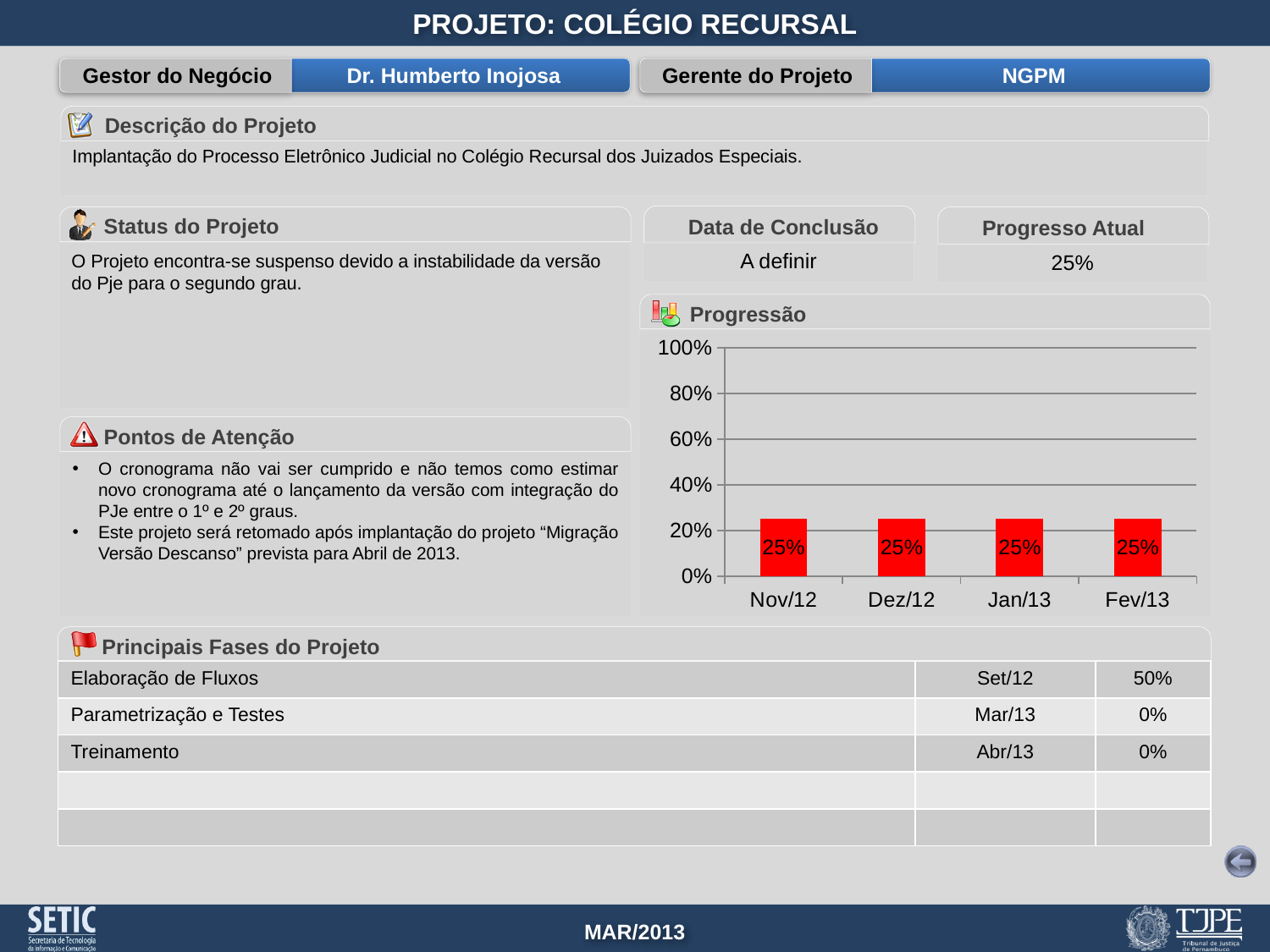
What colour are the bars in the Progressão chart? red Is the value for Dez/12 in the Progressão chart greater or less than 60%? less What is the value for Fev/13 in the Progressão chart? 25% What is the value for Dez/12 in the Progressão chart? 25% Do the values in the Progressão chart rise, fall or stay flat from Nov/12 to Fev/13? stay flat What kind of chart is the Progressão chart? bar chart What is the value for Nov/12 in the Progressão chart? 25% What is the value for Jan/13 in the Progressão chart? 25% How many categories are shown on the x axis of the Progressão chart? 4 What is the difference between the values for Fev/13 and Nov/12 in the Progressão chart? 0% Is the value for Jan/13 in the Progressão chart greater or less than 40%? less What is the title of the chart on the slide? Progressão